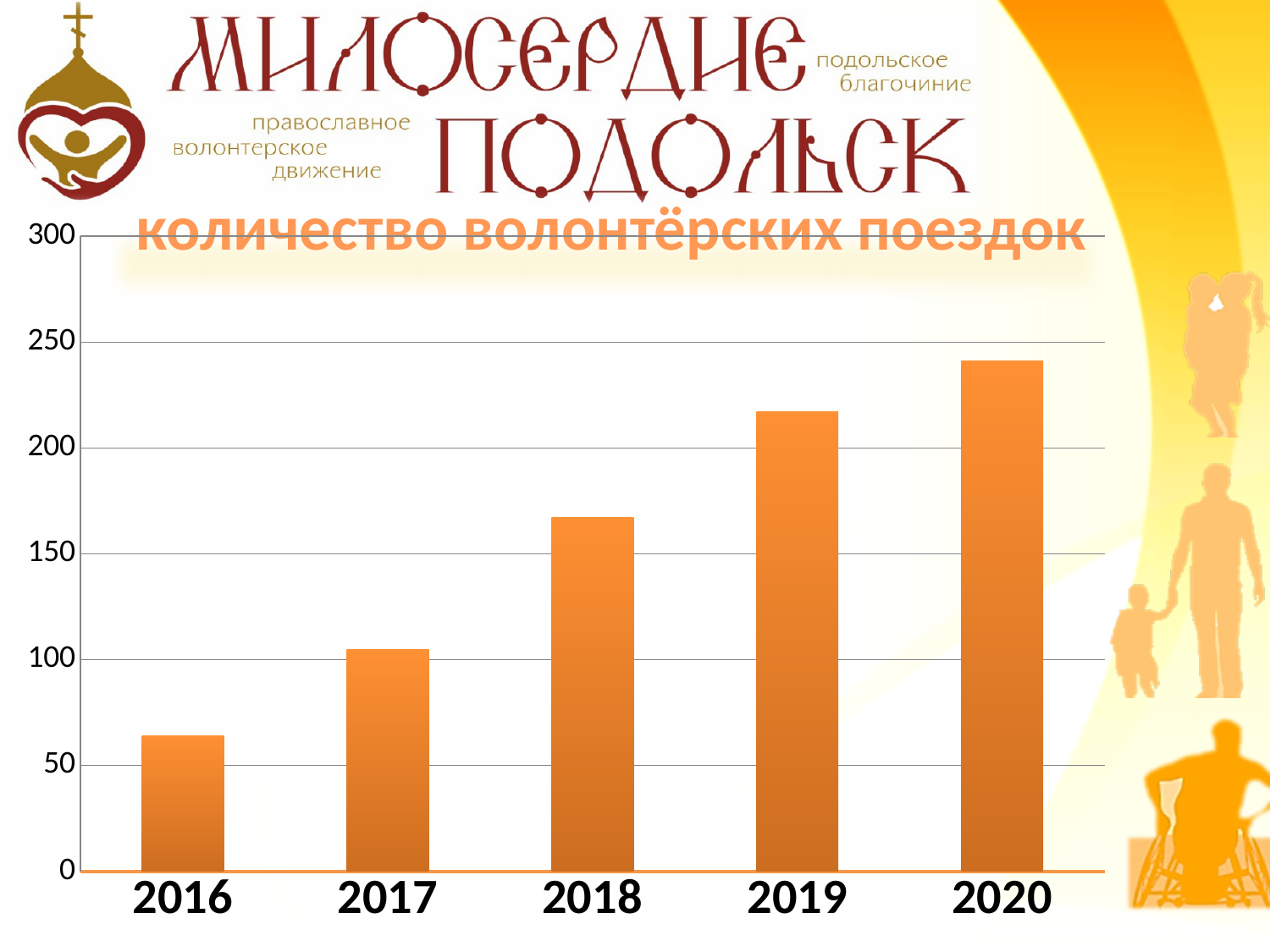
Is the value for 2017 greater or less than 150? less Which year has more volunteer trips, 2017 or 2019? 2019 Do the values rise or fall from 2016 to 2020? rise Is the value for 2019 greater or less than 200? greater Which year has the highest number of volunteer trips? 2020 What is the title of the chart? количество волонтёрских поездок Is the value for 2018 greater or less than 150? greater How many years are shown on the x axis of the chart? 5 What kind of chart is shown on the slide? bar chart Which year has the lowest number of volunteer trips? 2016